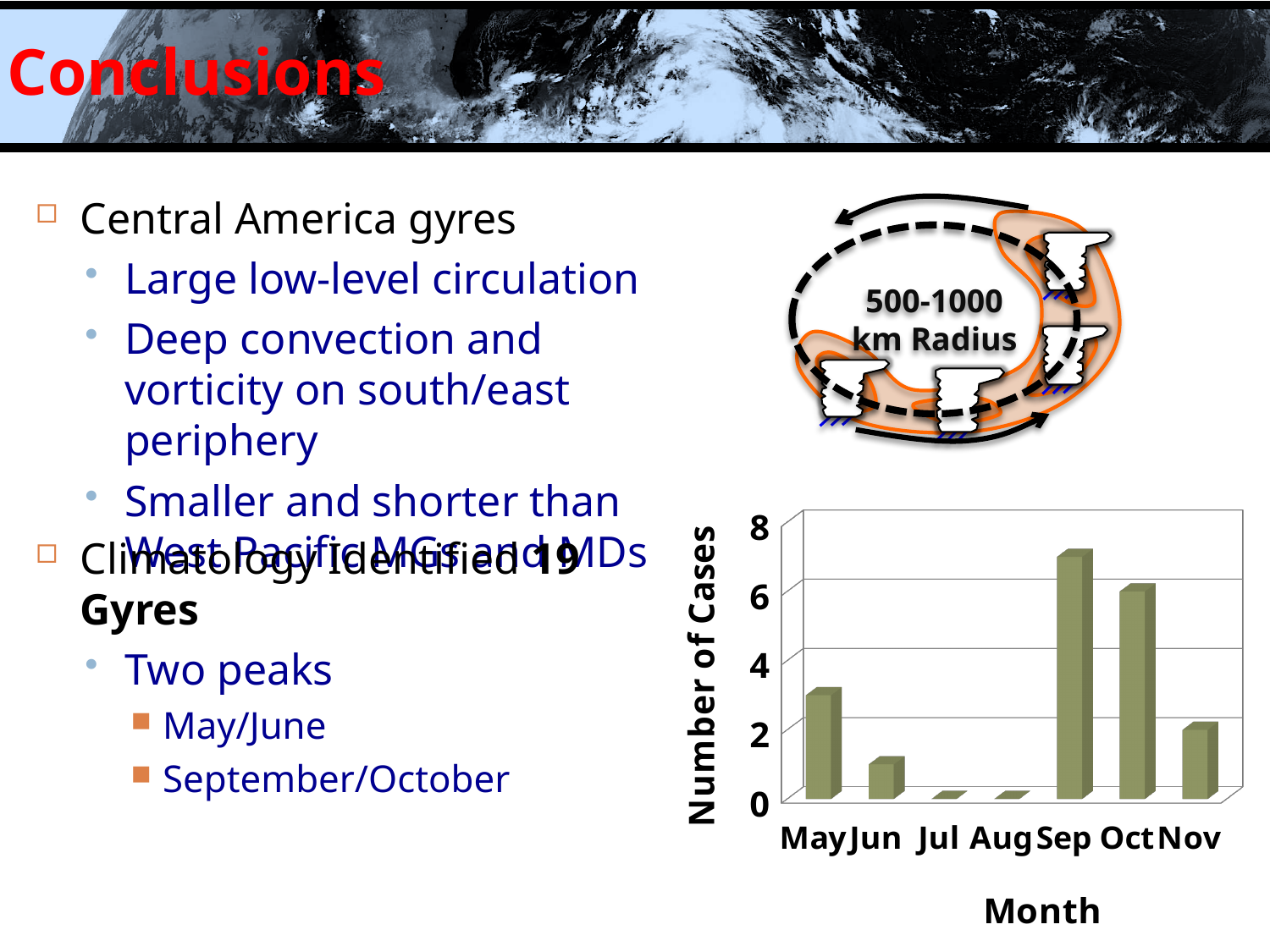
What is the number of cases for Oct? 6 What is the difference in number of cases between Oct and Nov? 4 How many months are shown on the x axis of the chart? 7 Which month has the highest number of cases? Sep Is the number of cases for Sep greater or less than 6? greater What is the number of cases for Nov? 2 What kind of chart is shown on the slide? bar chart What is the number of cases for Jul? 0 What is the label of the y axis of the chart? Number of Cases Is the number of cases for May greater or less than 2? greater Is the number of cases for Jun greater or less than 2? less Which month has more cases, Sep or May? Sep